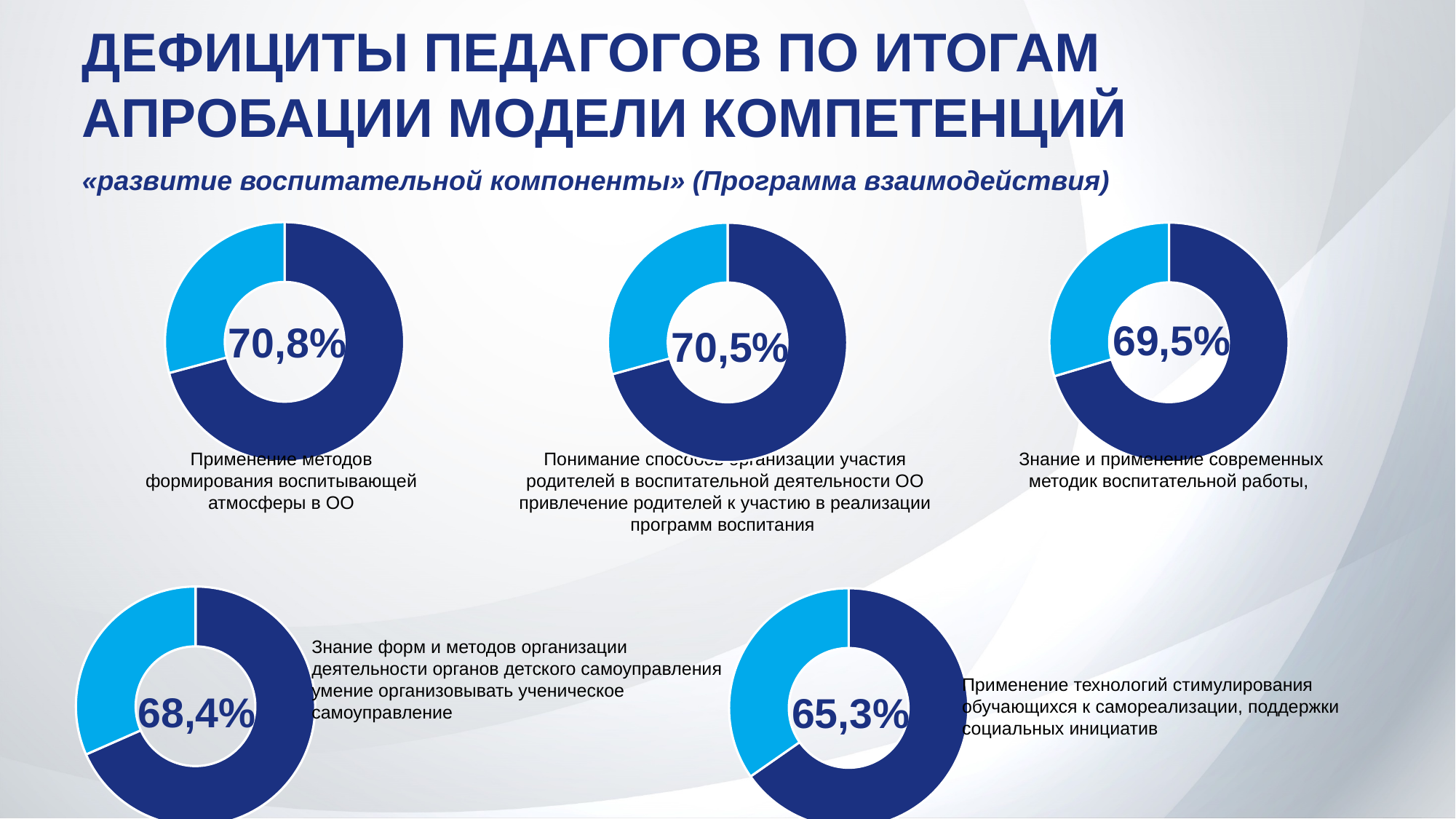
Which is larger: the value in the top-left chart (Применение методов формирования воспитывающей атмосферы) or the value in the top-middle chart (Понимание способов организации участия родителей)? Top-left chart (70,8%) What is the difference between the highest percentage (70,8%) and the lowest percentage (65,3%) shown on the slide? 5,5% What percentage is shown in the bottom-right donut chart (Применение технологий стимулирования обучающихся к самореализации)? 65,3% Which of the five donut charts shows the lowest percentage? Применение технологий стимулирования обучающихся к самореализации (65,3%) What percentage is shown in the bottom-left donut chart about student self-government (Знание форм и методов организации деятельности органов детского самоуправления)? 68,4% Which of the five donut charts shows the highest percentage? Применение методов формирования воспитывающей атмосферы в ОО (70,8%) What type of chart is used on this slide? Donut (pie) chart What is the difference between the top-right chart value (69,5%) and the bottom-left chart value (68,4%)? 1,1% What value is printed in the top-right donut chart (Знание и применение современных методик воспитательной работы)? 69,5% What percentage is shown in the centre of the top-left donut chart (Применение методов формирования воспитывающей атмосферы в ОО)? 70,8% How many donut charts are shown on the slide? 5 What percentage is shown in the top-middle donut chart about parents' participation in educational activities (Понимание способов организации участия родителей)? 70,5%